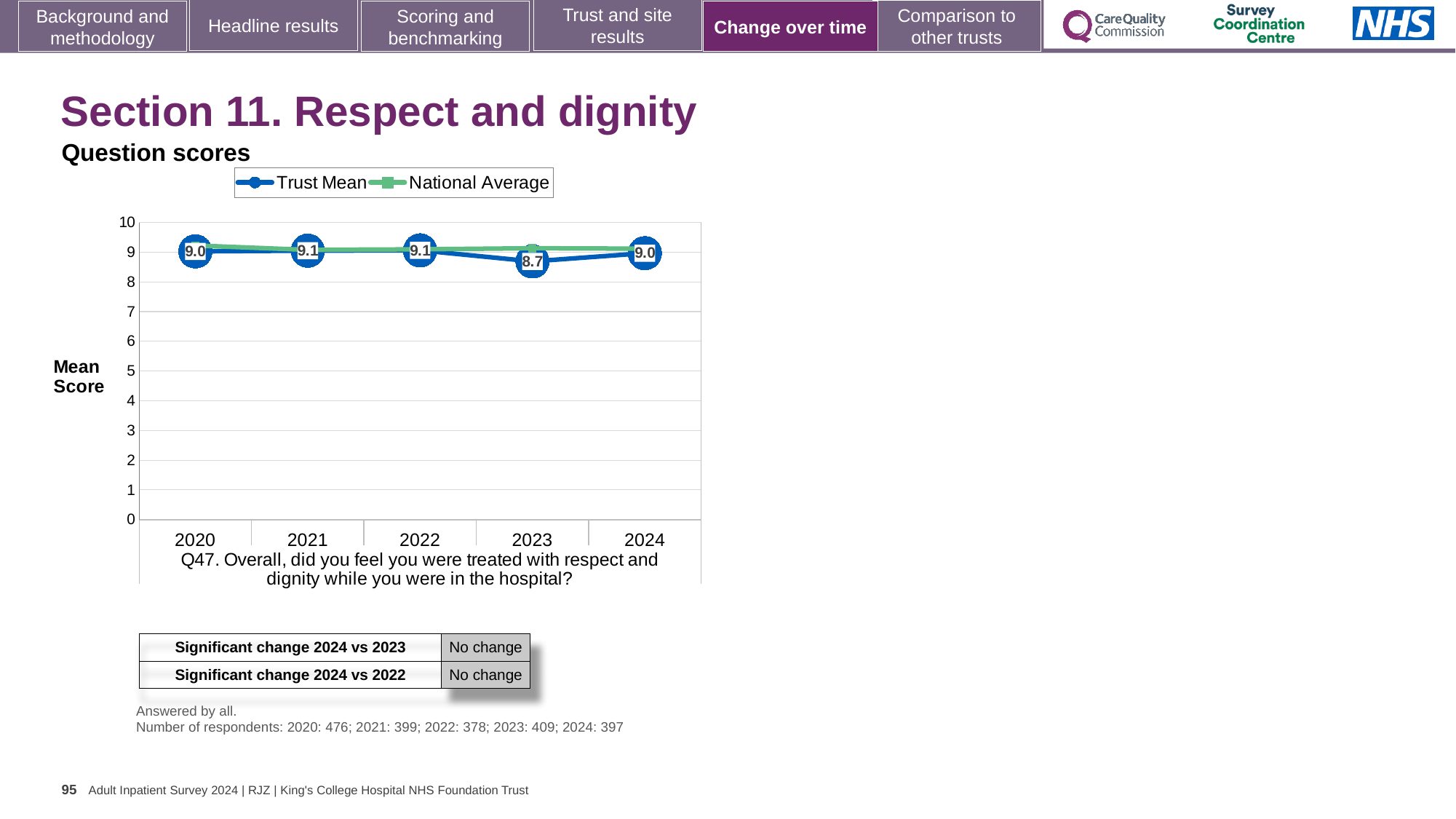
What is the Trust Mean score for 2021? 9.1 What is the Trust Mean score for 2023? 8.7 Is the National Average value for 2023 greater or less than 8? greater How many series does the legend list? 2 What is the Trust Mean score for 2020? 9.0 In which year is the Trust Mean score lowest? 2023 Which is larger, the Trust Mean score for 2021 or for 2023? 2021 What kind of chart is shown on the slide? Line chart Does the Trust Mean score rise or fall from 2023 to 2024? Rise How many years are plotted on the x axis? 5 What is the Trust Mean score for 2024? 9.0 What is the difference between the Trust Mean scores for 2022 and 2023? 0.4